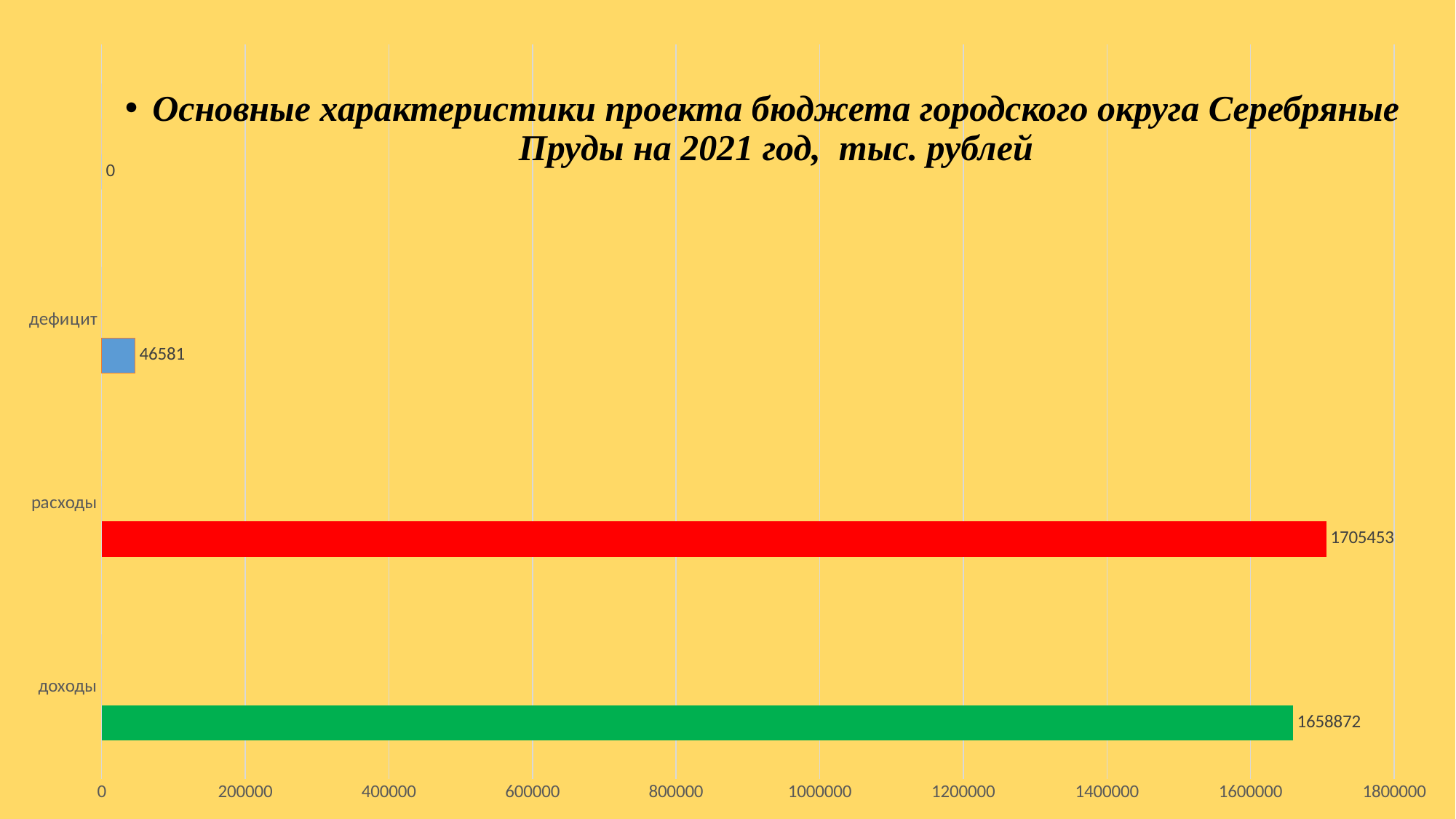
What is the value for расходы? 1705453 Which category has the highest value? расходы Is the value for доходы greater or less than 1600000? greater What is the highest value shown on the horizontal axis? 1800000 Is the value for дефицит greater or less than 200000? less Which is larger, доходы or расходы? расходы What is the value for доходы? 1658872 Which labeled category has the lowest value? дефицит What is the difference between расходы and доходы? 46581 What is the value for дефицит? 46581 What colour is the bar for расходы? red What kind of chart is shown on the slide? bar chart